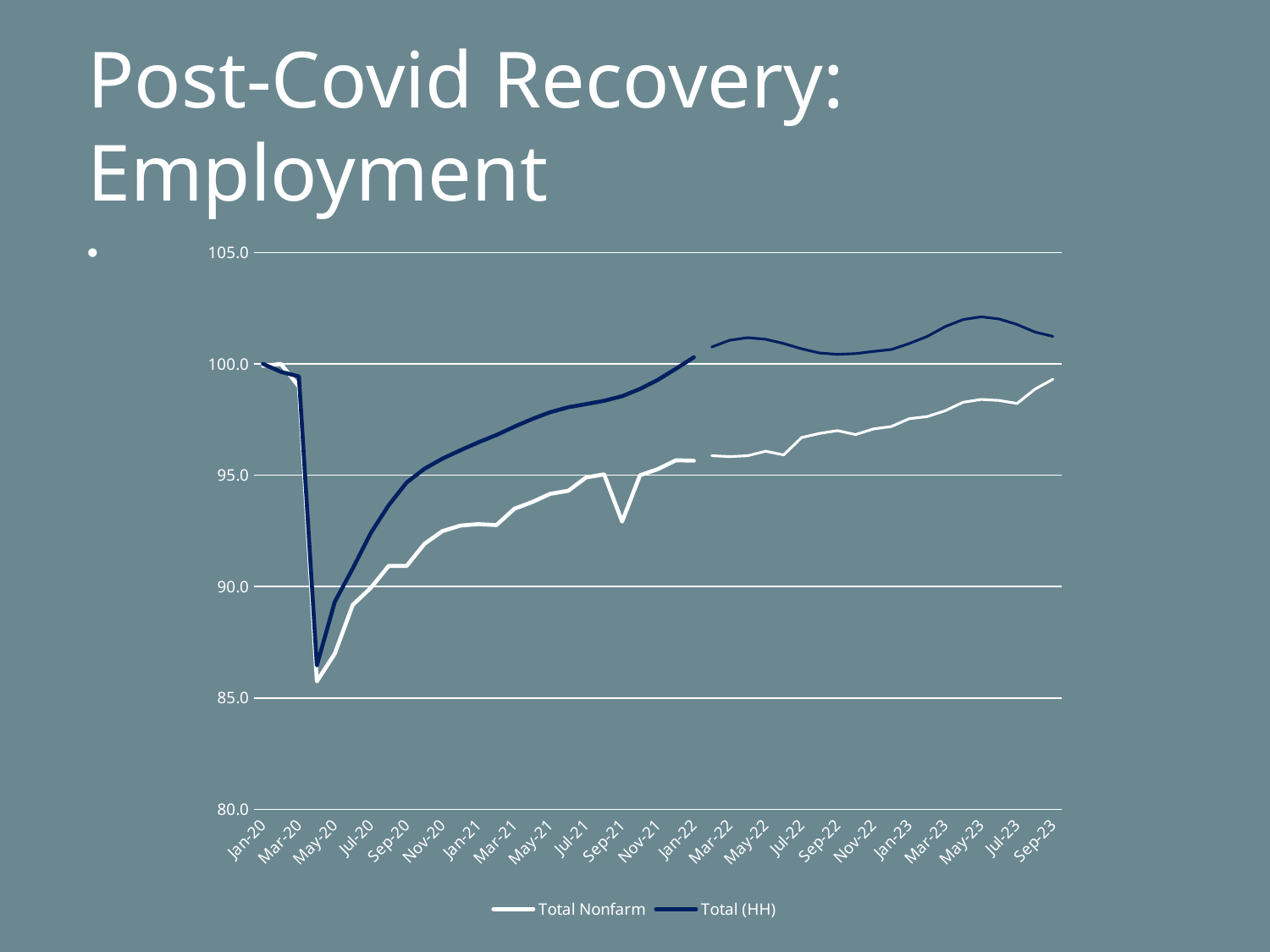
What are the two series named in the legend? Total Nonfarm and Total (HH) Does the Total Nonfarm series rise or fall overall from May-20 to Sep-23? rise Is the value for Total (HH) at May-23 greater or less than 100? greater Is the value for Total (HH) at Sep-23 greater or less than 100? greater At Sep-23, which series has the higher value, Total Nonfarm or Total (HH)? Total (HH) Is the value for Total (HH) at Jan-21 greater or less than 95? greater What kind of chart is shown on the slide? Line chart How many month labels are shown along the x axis? 23 What is the highest value shown on the vertical axis? 105.0 How many series does the legend list? 2